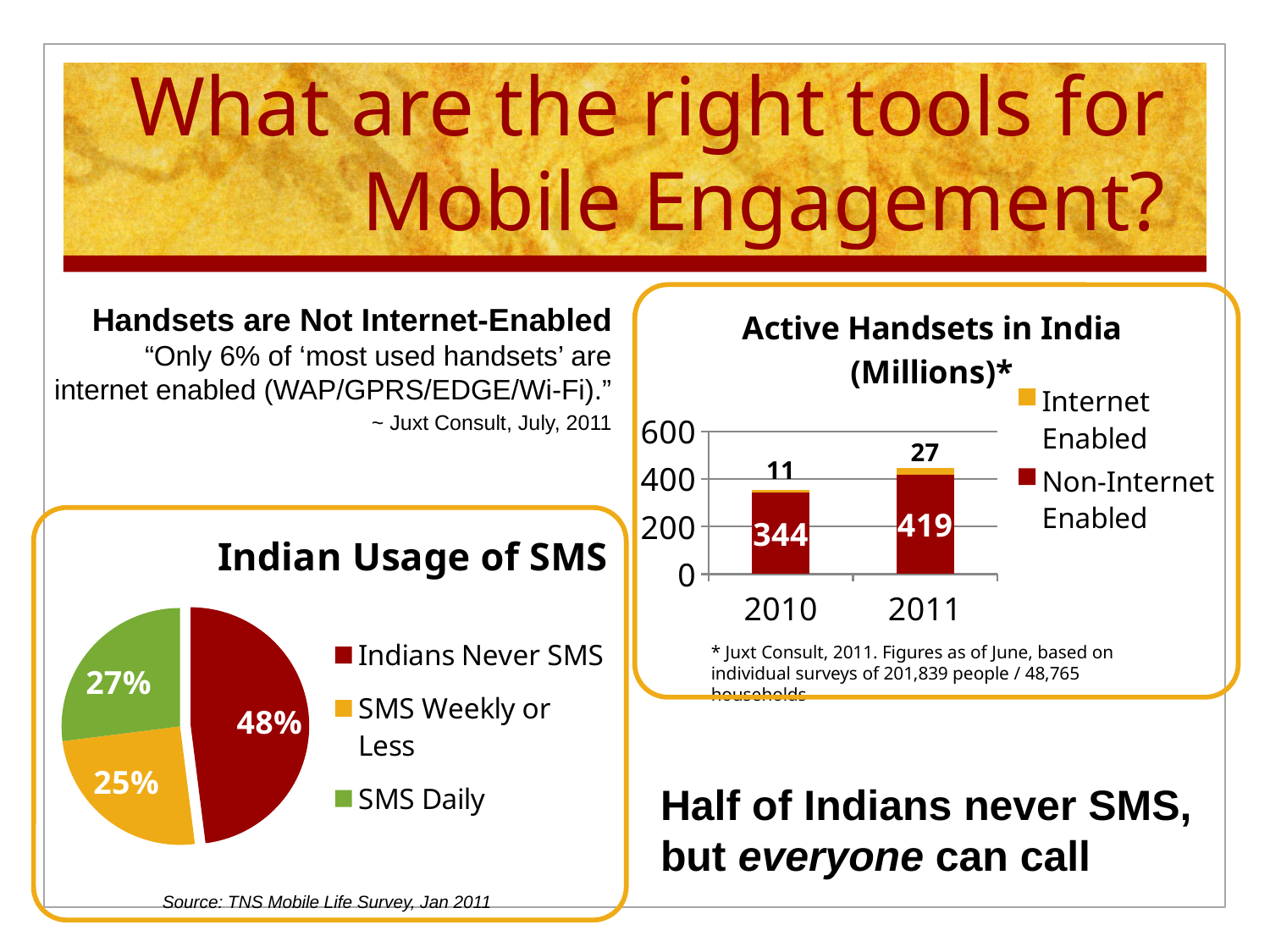
In the 'Indian Usage of SMS' pie chart, which category has the smallest slice? SMS Weekly or Less In the 'Active Handsets in India (Millions)' chart, what is the total of the stacked bar for 2011? 446 In the 'Active Handsets in India (Millions)' chart, what is the Non-Internet Enabled value for 2011? 419 In the 'Active Handsets in India (Millions)' chart, how much did the Non-Internet Enabled value increase from 2010 to 2011? 75 In the 'Active Handsets in India (Millions)' chart, what is the Internet Enabled value for 2010? 11 In the 'Indian Usage of SMS' pie chart, how many slices are there? 3 In the 'Indian Usage of SMS' pie chart, what share is labelled 'SMS Daily'? 27% In the 'Active Handsets in India (Millions)' chart, do the Internet Enabled values rise or fall from 2010 to 2011? Rise What kind of chart is 'Indian Usage of SMS'? Pie chart In the 'Indian Usage of SMS' pie chart, what share of Indians never SMS? 48% In the 'Active Handsets in India (Millions)' chart, how many series does the legend list? 2 In the 'Indian Usage of SMS' pie chart, what is the difference between the 'Indians Never SMS' share and the 'SMS Daily' share? 21%